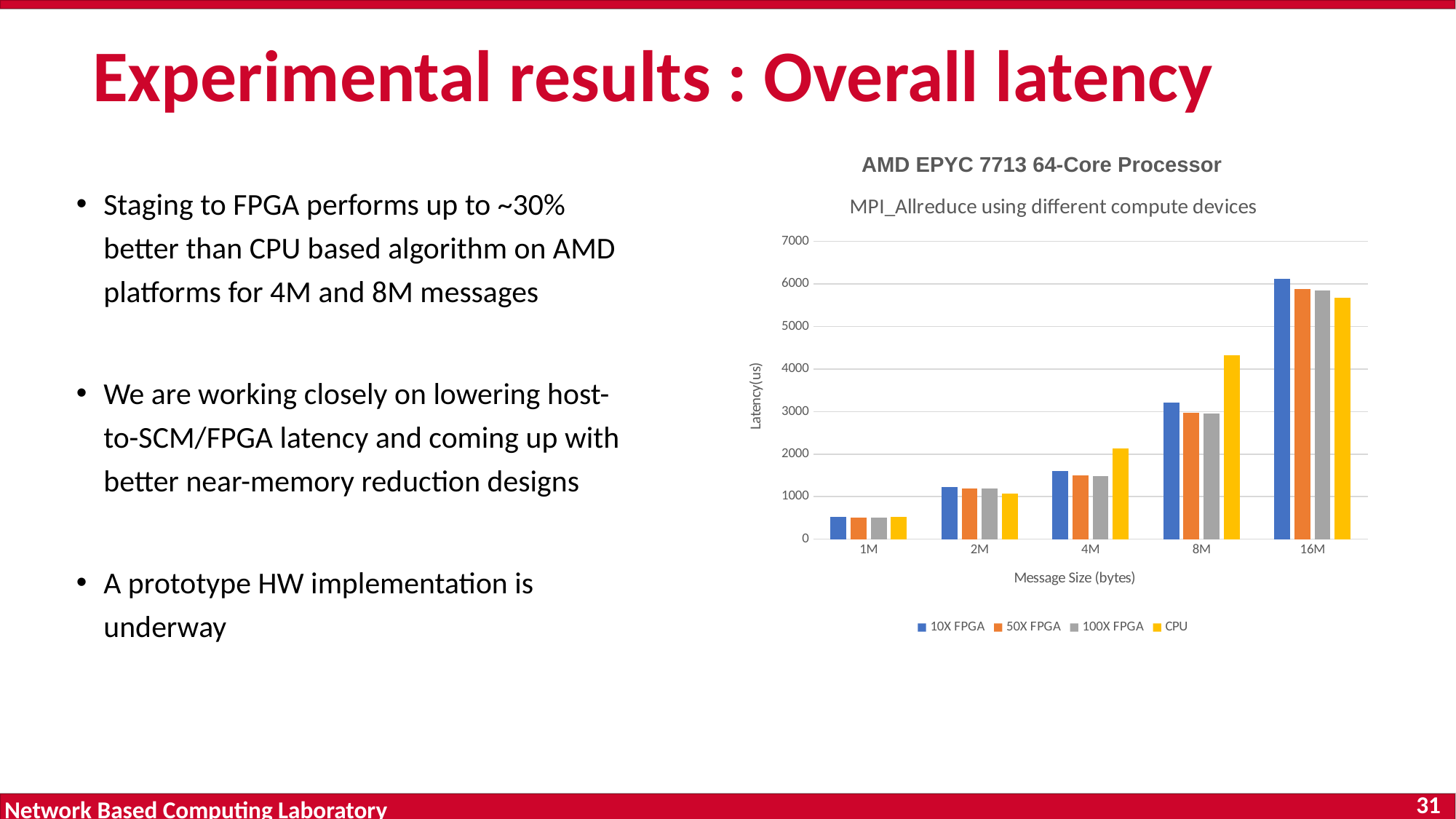
Is the 10X FPGA latency for the 8M message size greater or less than 3000? greater How many series does the chart legend list? 4 Which series has the highest latency at the 4M message size? CPU Is the CPU latency for the 8M message size greater or less than 4000? greater At the 8M message size, which has the higher latency: CPU or 10X FPGA? CPU What is the label of the x axis of the chart? Message Size (bytes) For the CPU series, which message size has the lowest latency? 1M Does the 10X FPGA latency rise or fall as the message size increases from 1M to 16M? rises How many message sizes are shown on the x axis of the chart? 5 What kind of chart is shown on the slide? bar chart At the 16M message size, which has the higher latency: 10X FPGA or CPU? 10X FPGA Is the CPU latency for the 4M message size greater or less than 2000? greater